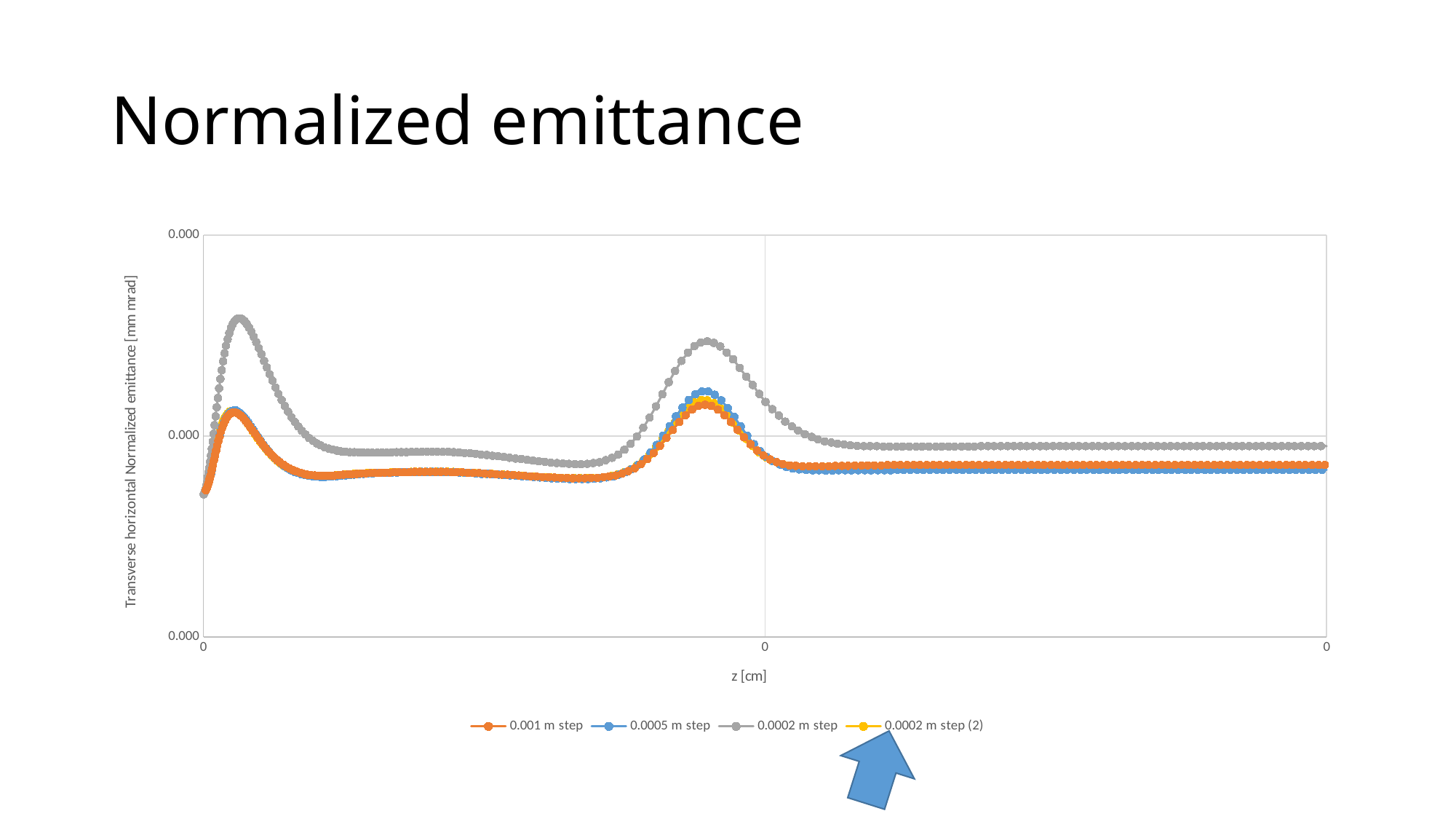
How many peaks does the 0.0002 m step series show along the x axis? 2 How many series does the legend list? 4 What kind of chart is shown on the slide? line chart What is the label of the x axis? z [cm] Which series has a higher first peak, 0.0002 m step or 0.001 m step? 0.0002 m step What is the title of the slide containing the chart? Normalized emittance Which series reaches the highest peak on the chart? 0.0002 m step Does the 0.0002 m step series rise or fall immediately after its first peak? fall Which series lies highest at the right-hand end of the x axis? 0.0002 m step